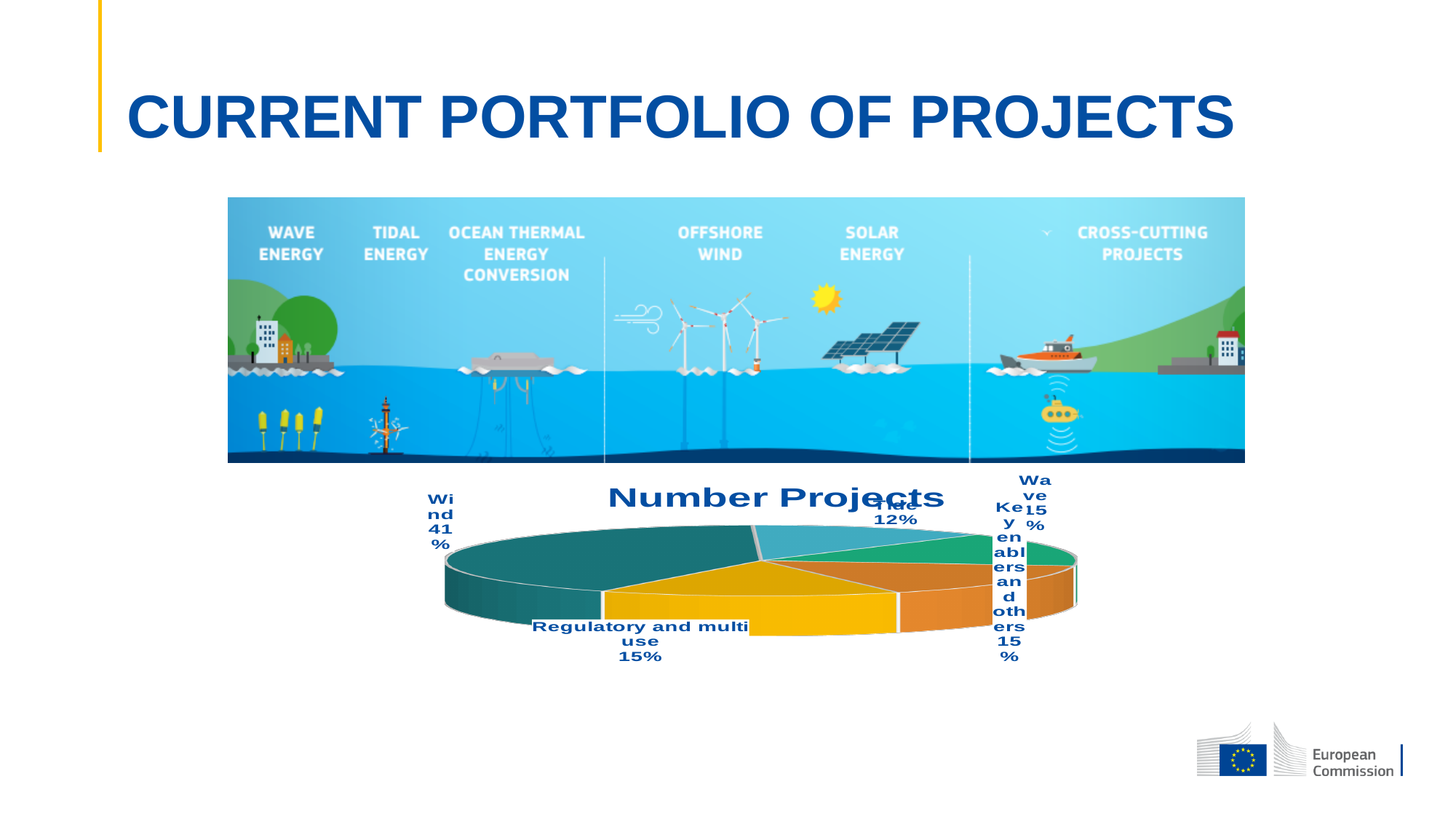
How many slices does the pie chart have? 5 What share of the pie does Wind account for? 41% What share of the pie does Key enablers and others account for? 15% What share of the pie does Tide account for? 12% Which category has the smallest slice of the pie? Tide What share of the pie does Regulatory and multi use account for? 15% What share of the pie does Wave account for? 15% What is the title of the chart? Number Projects Which category has the largest slice of the pie? Wind What kind of chart is shown on the slide? Pie chart Which is larger, the Wind share or the Wave share? Wind What is the difference in percentage points between the Wind share and the Tide share? 29 percentage points